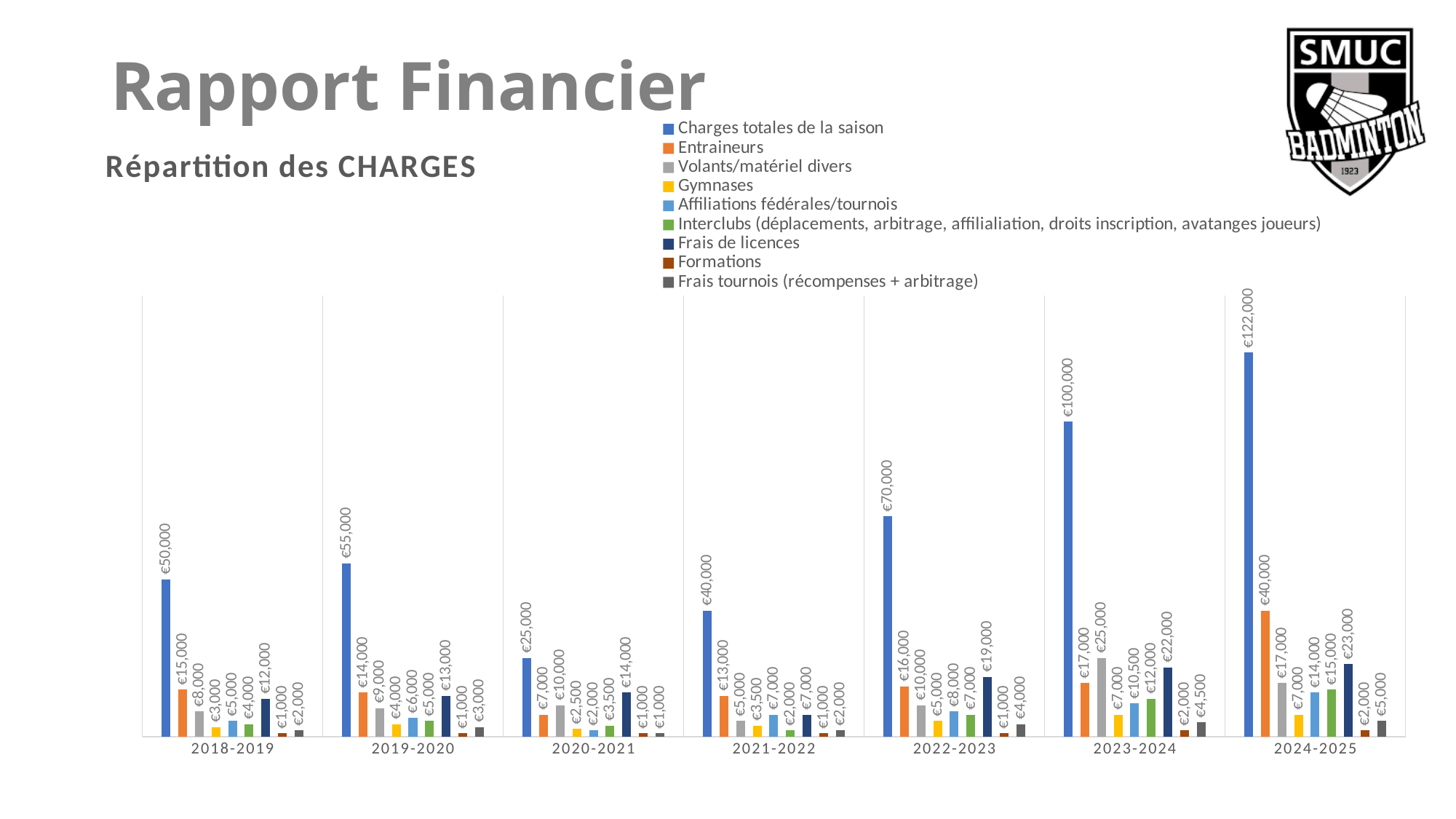
How many series does the legend list? 9 What is the subtitle of the chart below the slide title? Répartition des CHARGES How many seasons are shown on the x axis? 7 What is the difference between Charges totales de la saison in 2023-2024 and in 2022-2023? €30,000 What kind of chart is shown on the slide? Bar chart What is the value of Entraineurs for 2021-2022? €13,000 What is the value of Volants/matériel divers for 2023-2024? €25,000 Which is larger in 2020-2021: Entraineurs or Volants/matériel divers? Volants/matériel divers Which season has the lowest value for Charges totales de la saison? 2020-2021 What is the value of Frais de licences for 2022-2023? €19,000 What is the value of Charges totales de la saison for 2024-2025? €122,000 Which season has the highest value for Entraineurs? 2024-2025